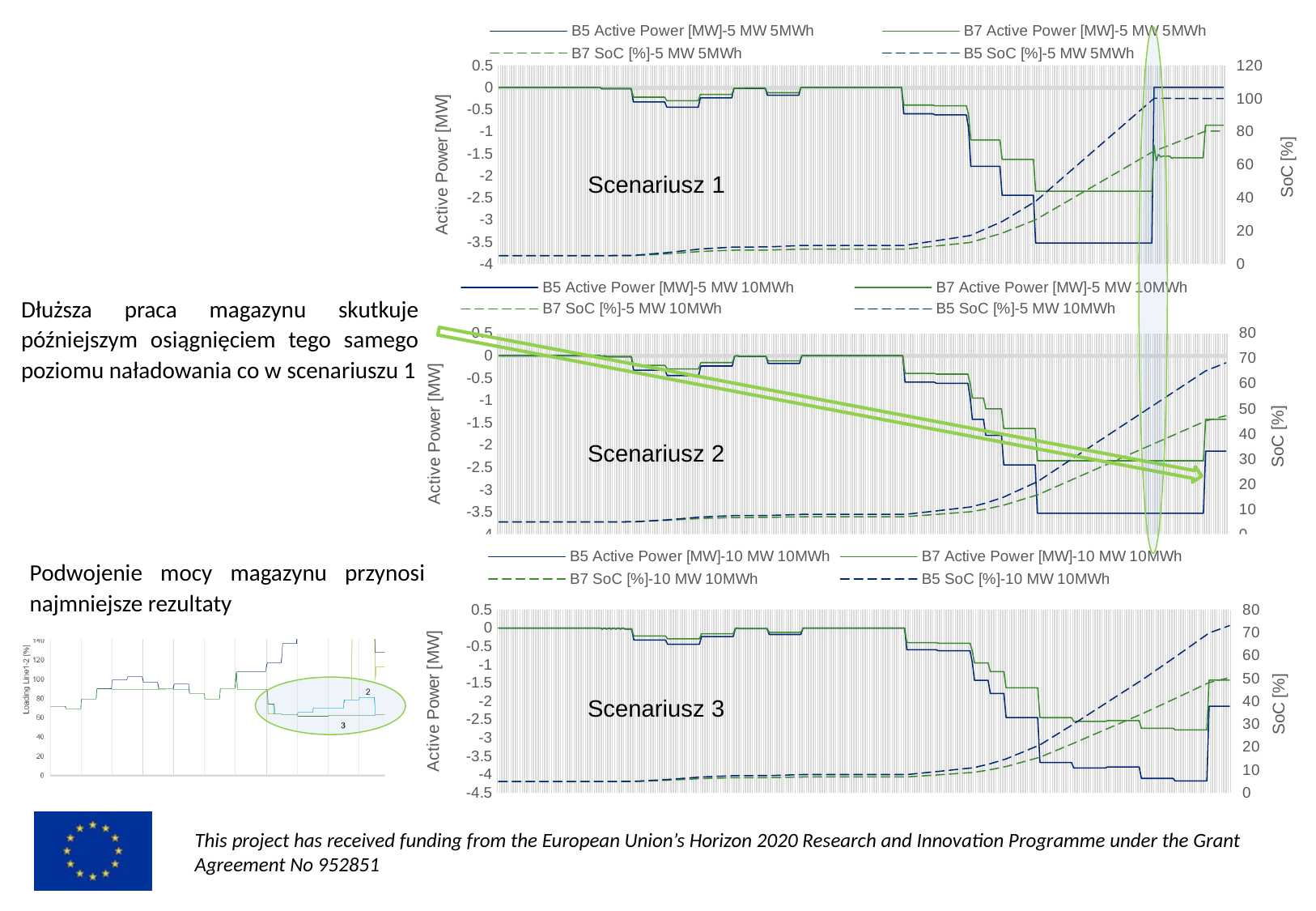
In the Scenariusz 3 chart, is the final value of the B5 SoC [%]-10 MW 10MWh line greater or less than 60? greater In the Scenariusz 2 chart, is the final value of the B7 SoC [%]-5 MW 10MWh line greater or less than 60? less In the Scenariusz 3 chart, what is the label of the left-hand vertical axis? Active Power [MW] In the Scenariusz 1 chart, is the lowest value of the B5 Active Power [MW]-5 MW 5MWh line greater or less than -3? less What kind of chart is the Scenariusz 1 chart? line chart In the Scenariusz 1 chart, what is the label of the right-hand vertical axis? SoC [%] In the Scenariusz 2 chart, does the B5 SoC [%]-5 MW 10MWh line rise or fall along the x axis? rise How many series does the legend of the Scenariusz 3 chart list? 4 How many series does the legend of the Scenariusz 2 chart list? 4 In the Scenariusz 1 chart, which series ends at a higher SoC value: B5 SoC [%]-5 MW 5MWh or B7 SoC [%]-5 MW 5MWh? B5 SoC [%]-5 MW 5MWh